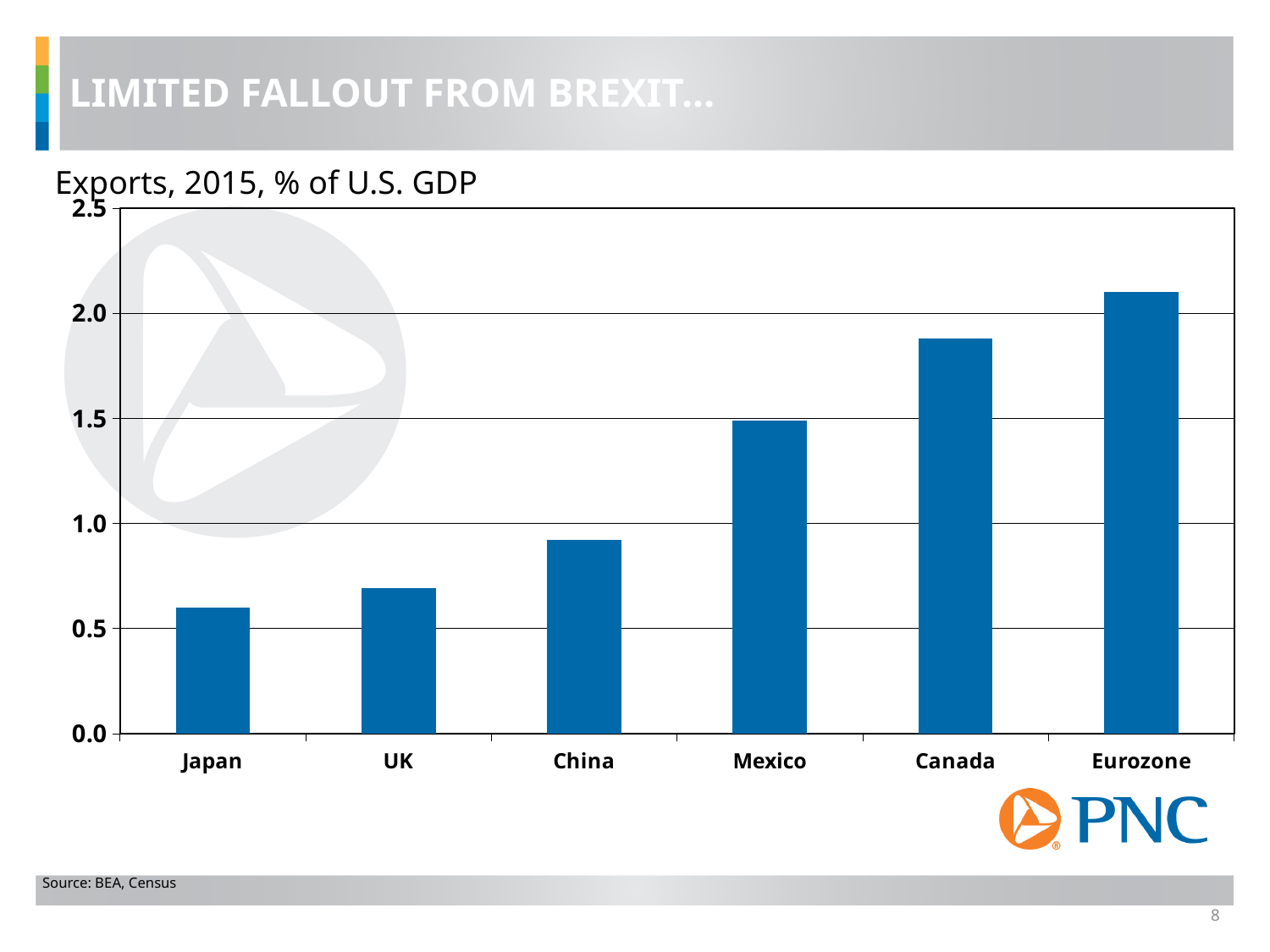
Is the value for Mexico greater or less than 1.0? greater Do the bar values rise or fall moving from left to right along the x axis? rise Is the value for China greater or less than 1.0? less What kind of chart is shown on the slide? bar chart What is the title of the chart? Exports, 2015, % of U.S. GDP Is the value for Eurozone greater or less than 2.0? greater Which category has the highest exports as a % of U.S. GDP? Eurozone Which is larger, the value for Canada or the value for Mexico? Canada Which category has the lowest exports as a % of U.S. GDP? Japan How many countries or regions are shown on the x axis of the chart? 6